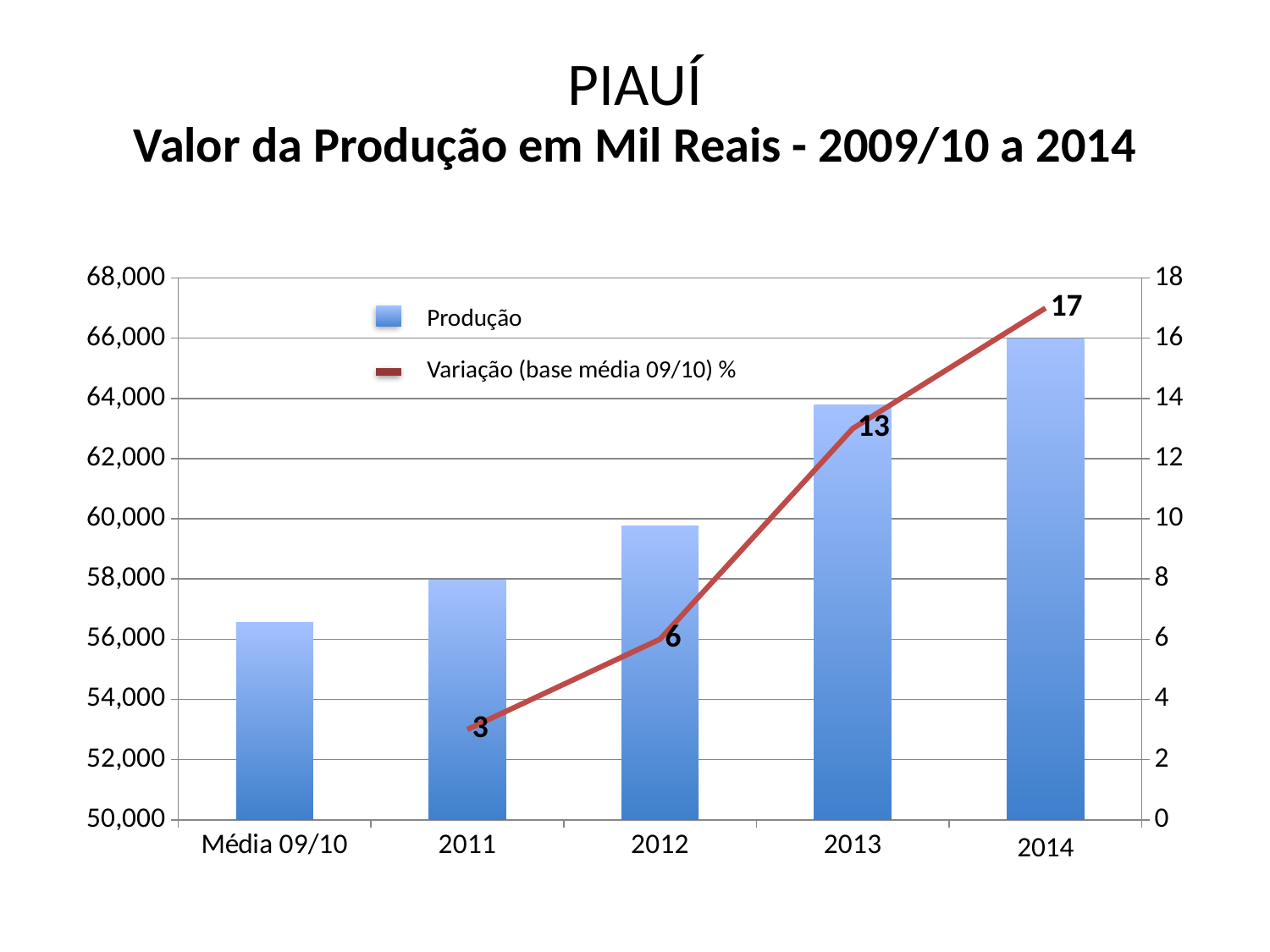
What is the Variação (base média 09/10) % value for 2012? 6 What is the Variação (base média 09/10) % value for 2014? 17 What is the Variação (base média 09/10) % value for 2013? 13 How many categories are shown on the x axis? 5 Which year has the highest Variação (base média 09/10) % value? 2014 What is the Variação (base média 09/10) % value for 2011? 3 What is the difference between the Variação values for 2014 and 2011? 14 Which year has the lowest Variação (base média 09/10) % value? 2011 Is the Produção value for 2013 greater or less than 62,000? greater Is the Produção value for Média 09/10 greater or less than 58,000? less How many series does the legend list? 2 Which has a larger Produção value, 2012 or 2014? 2014